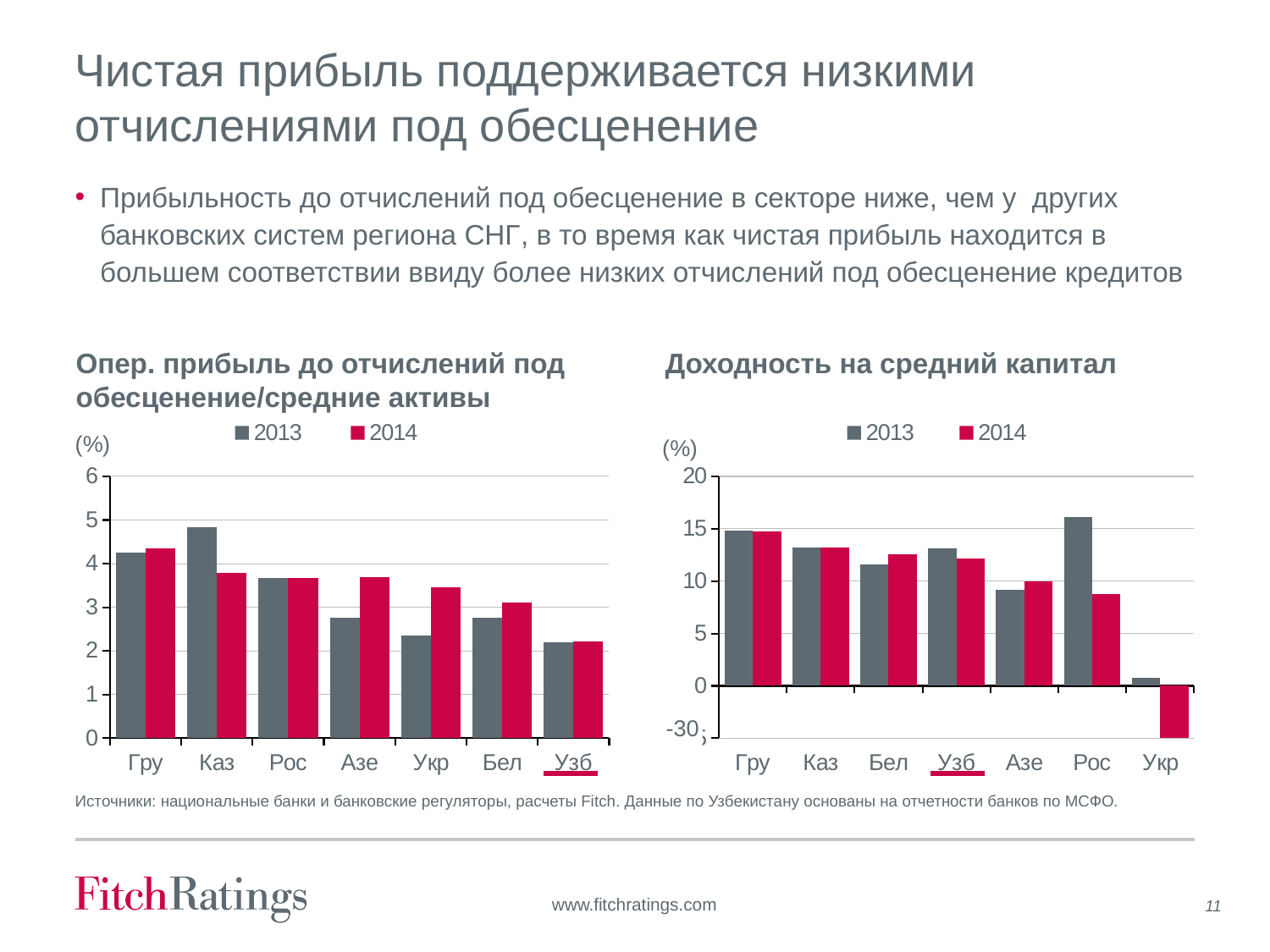
What is the title of the right chart? Доходность на средний капитал In the left chart, which category has the lowest 2013 value? Узб What kind of chart is the left chart, 'Опер. прибыль до отчислений под обесценение/средние активы'? bar chart In the left chart, is the 2013 value for Каз greater or less than 4? greater How many categories are shown on the x axis of the right chart, 'Доходность на средний капитал'? 7 In the right chart, which is larger for Рос: the 2013 value or the 2014 value? 2013 How many series does the legend of the left chart list? 2 In the right chart, which category has the highest 2013 value? Рос In the left chart, which category has the highest 2013 value? Каз In the right chart, is the 2014 value for Рос greater or less than 10? less In the left chart, which is larger for Укр: the 2013 value or the 2014 value? 2014 In the right chart, which category has the lowest 2014 value? Укр